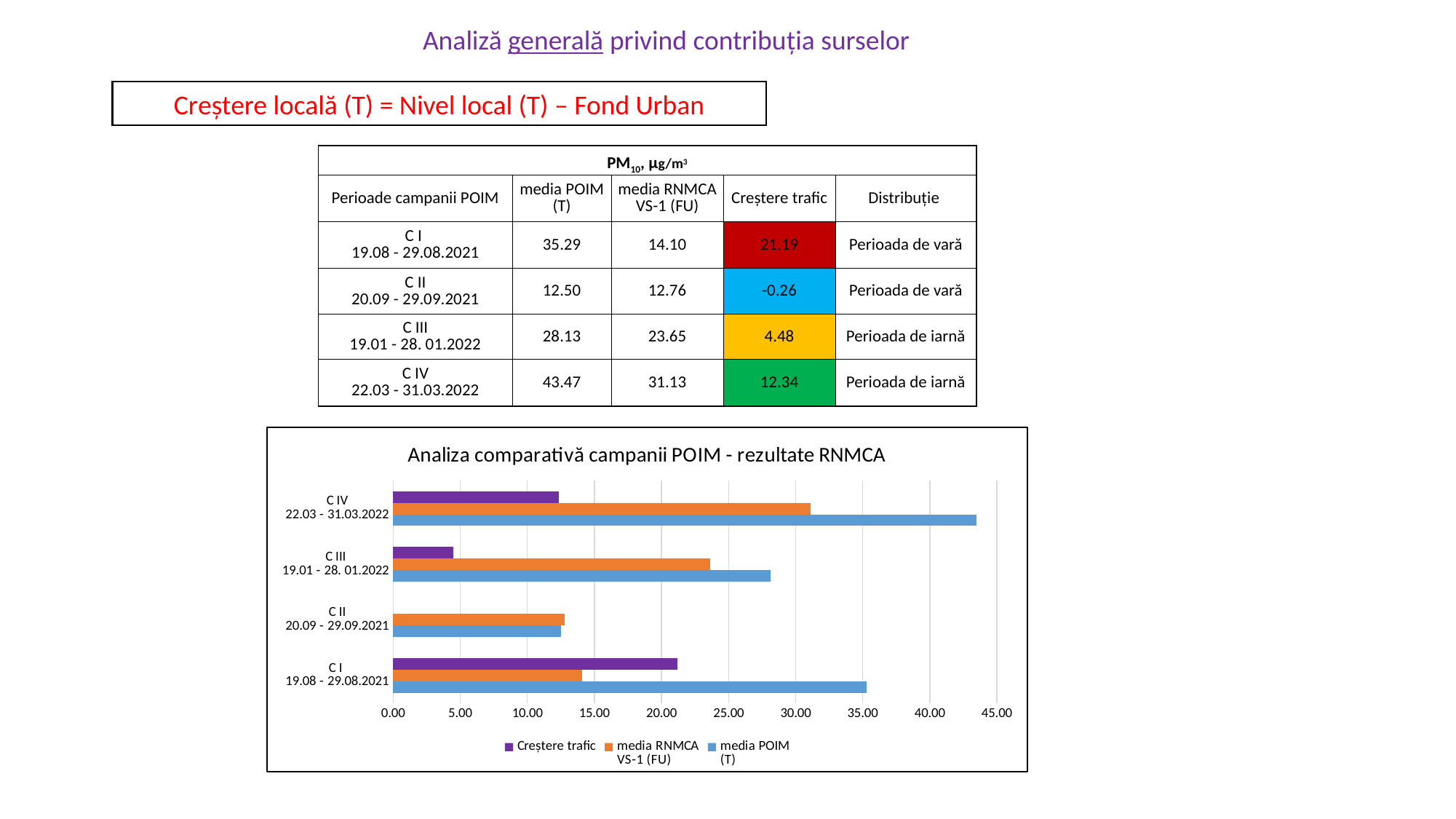
How many campaign categories are shown on the chart's vertical axis? 4 In the chart, is the 'media RNMCA VS-1 (FU)' value for C IV greater or less than 25.00? greater In the chart, is the 'media POIM (T)' value for C IV greater or less than 40.00? greater Which campaign has the highest 'media POIM (T)' value in the chart? C IV 22.03 - 31.03.2022 How many series does the legend of the chart list? 3 What type of chart is 'Analiza comparativă campanii POIM - rezultate RNMCA'? bar chart What colour represents the 'Creștere trafic' series in the chart? purple Which campaign has the highest 'Creștere trafic' value in the chart? C I 19.08 - 29.08.2021 Which campaign has the lowest 'media POIM (T)' value in the chart? C II 20.09 - 29.09.2021 What is the 'media RNMCA VS-1 (FU)' value for campaign C III (19.01 - 28.01.2022)? 23.65 In the chart, is the 'Creștere trafic' value for C III greater or less than 10.00? less For campaign C I, which is larger in the chart: 'media POIM (T)' or 'media RNMCA VS-1 (FU)'? media POIM (T)